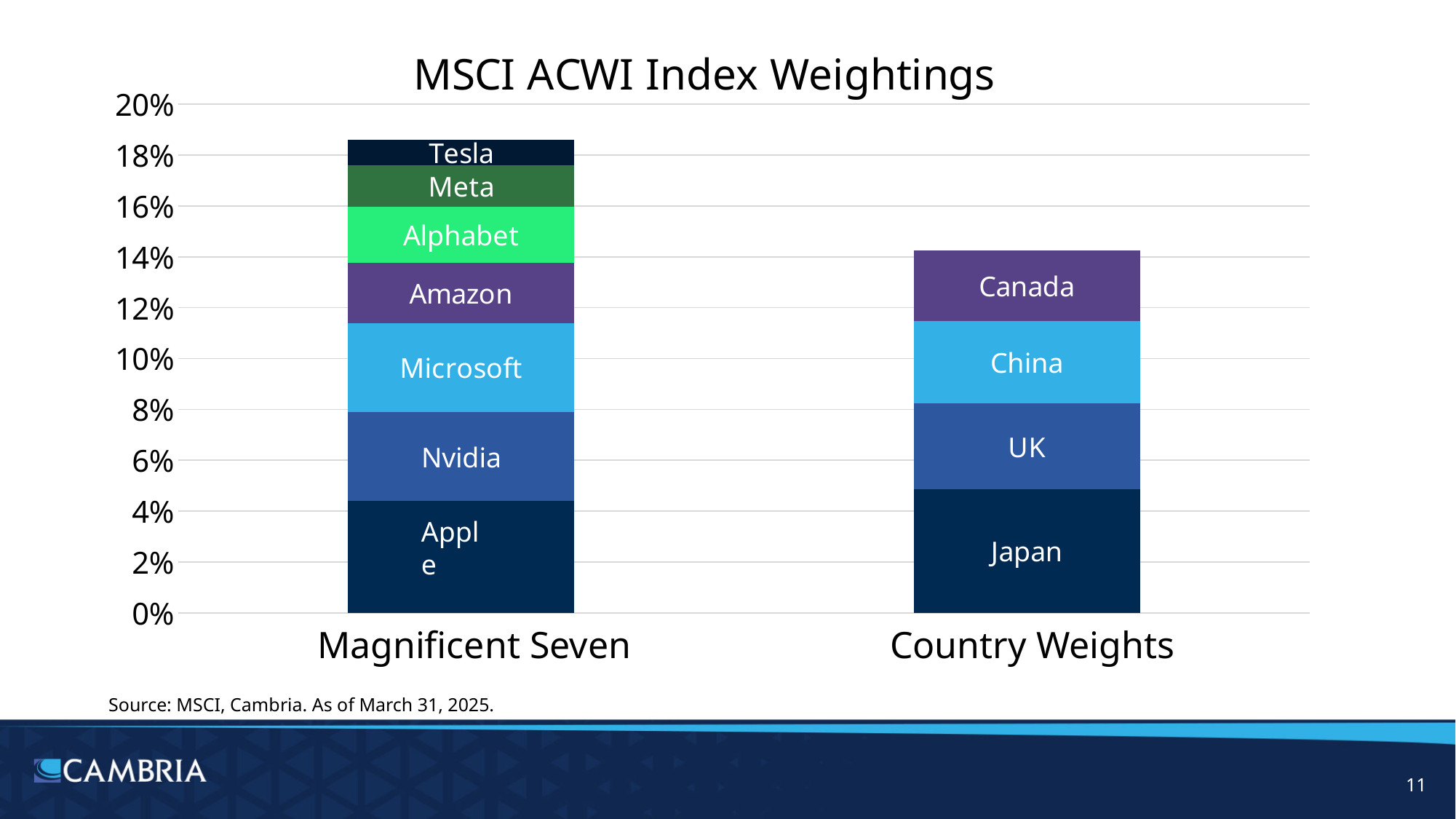
What is the title of the chart? MSCI ACWI Index Weightings How many segments make up the Country Weights bar? 4 Which segment sits at the bottom of the Country Weights bar? Japan Is the total of the Magnificent Seven bar greater or less than 18%? greater Is the total of the Country Weights bar greater or less than 16%? less Which segment is the largest in the Magnificent Seven bar? Apple Which segment is the smallest in the Magnificent Seven bar? Tesla How many segments make up the Magnificent Seven bar? 7 Which segment is the largest in the Country Weights bar? Japan Which bar is taller, Magnificent Seven or Country Weights? Magnificent Seven How many bars (categories) are shown on the x axis? 2 What kind of chart is shown on the slide? stacked bar chart